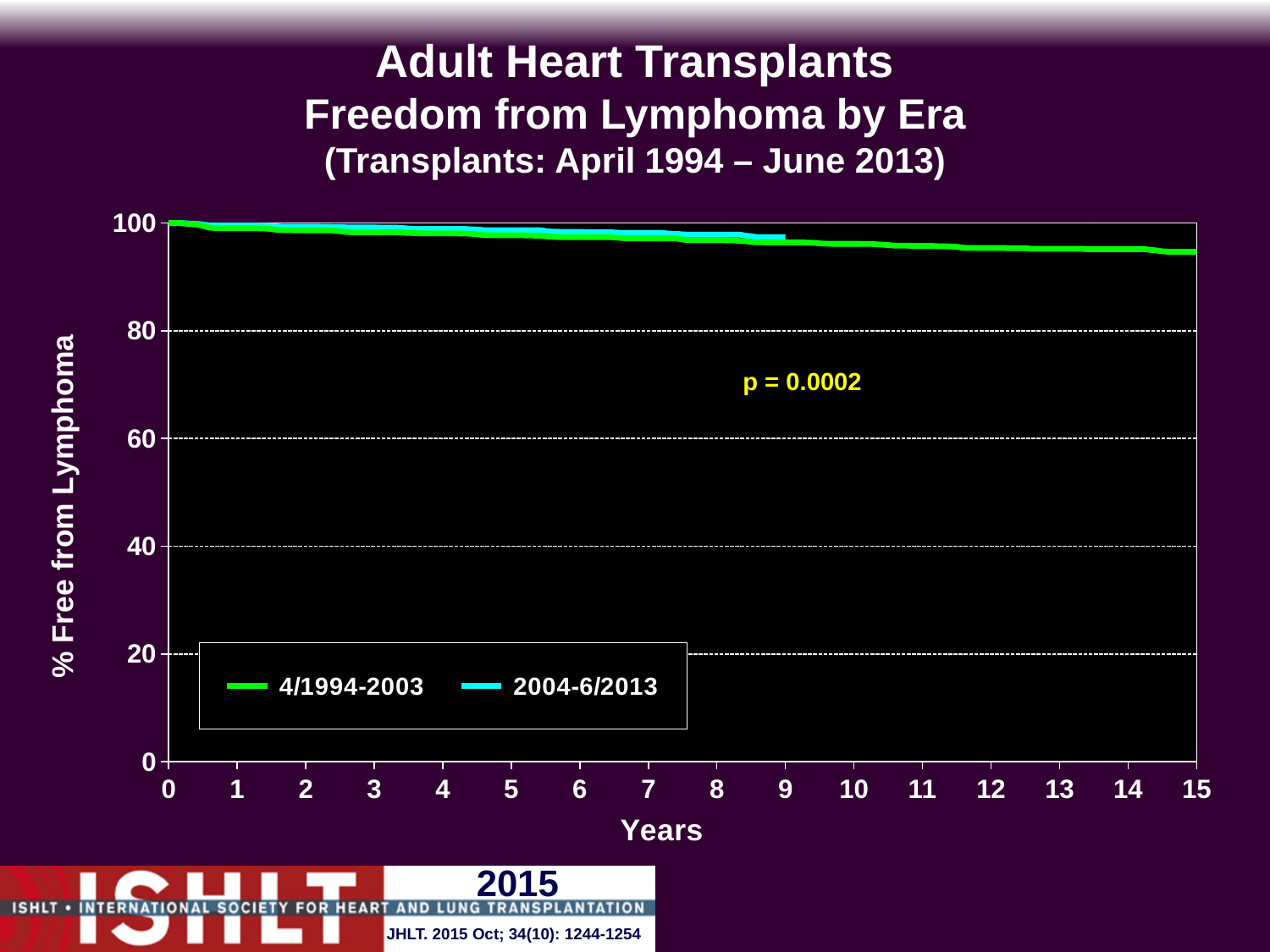
How many series does the legend list? 2 What kind of chart is shown on the slide? Line chart Is the value for the 4/1994-2003 series at year 10 greater or less than 60? greater What are the two series named in the legend? 4/1994-2003 and 2004-6/2013 Which series extends further along the x axis, 4/1994-2003 or 2004-6/2013? 4/1994-2003 Do the values for the 4/1994-2003 series rise or fall as years increase? Fall What is the p-value printed on the chart? p = 0.0002 Is the value for the 4/1994-2003 series at year 15 greater or less than 80? greater What is the label of the y axis? % Free from Lymphoma What is the highest value shown on the x axis (Years)? 15 Is the value for the 2004-6/2013 series at year 5 greater or less than 80? greater What is the title of the chart? Adult Heart Transplants Freedom from Lymphoma by Era (Transplants: April 1994 – June 2013)